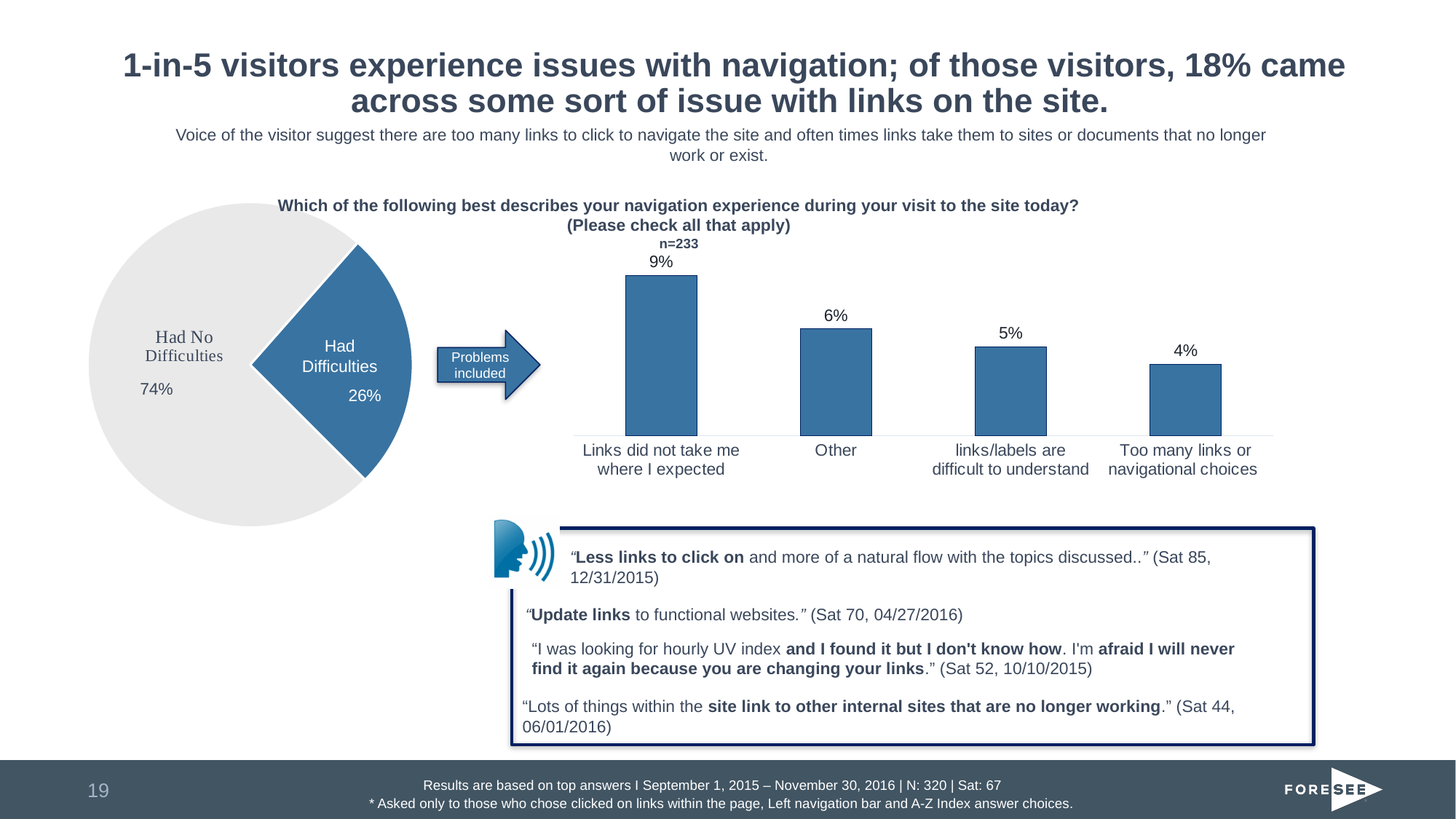
In the bar chart on the right, which category has the highest value? Links did not take me where I expected In the pie chart on the left, what share of visitors had no difficulties? 74% In the bar chart on the right, how many categories are shown? 4 In the pie chart on the left, what share of visitors had difficulties? 26% In the bar chart on the right, what is the difference between 'Links did not take me where I expected' and 'links/labels are difficult to understand'? 4% In the bar chart on the right, which category has the lowest value? Too many links or navigational choices In the pie chart on the left, which slice is larger, Had No Difficulties or Had Difficulties? Had No Difficulties In the bar chart on the right, what is the value for 'Links did not take me where I expected'? 9% In the bar chart on the right, do the values rise or fall from left to right? fall In the pie chart on the left, how many slices are there? 2 In the bar chart on the right, what is the value for 'Too many links or navigational choices'? 4% In the bar chart on the right, what is the value for 'Other'? 6%